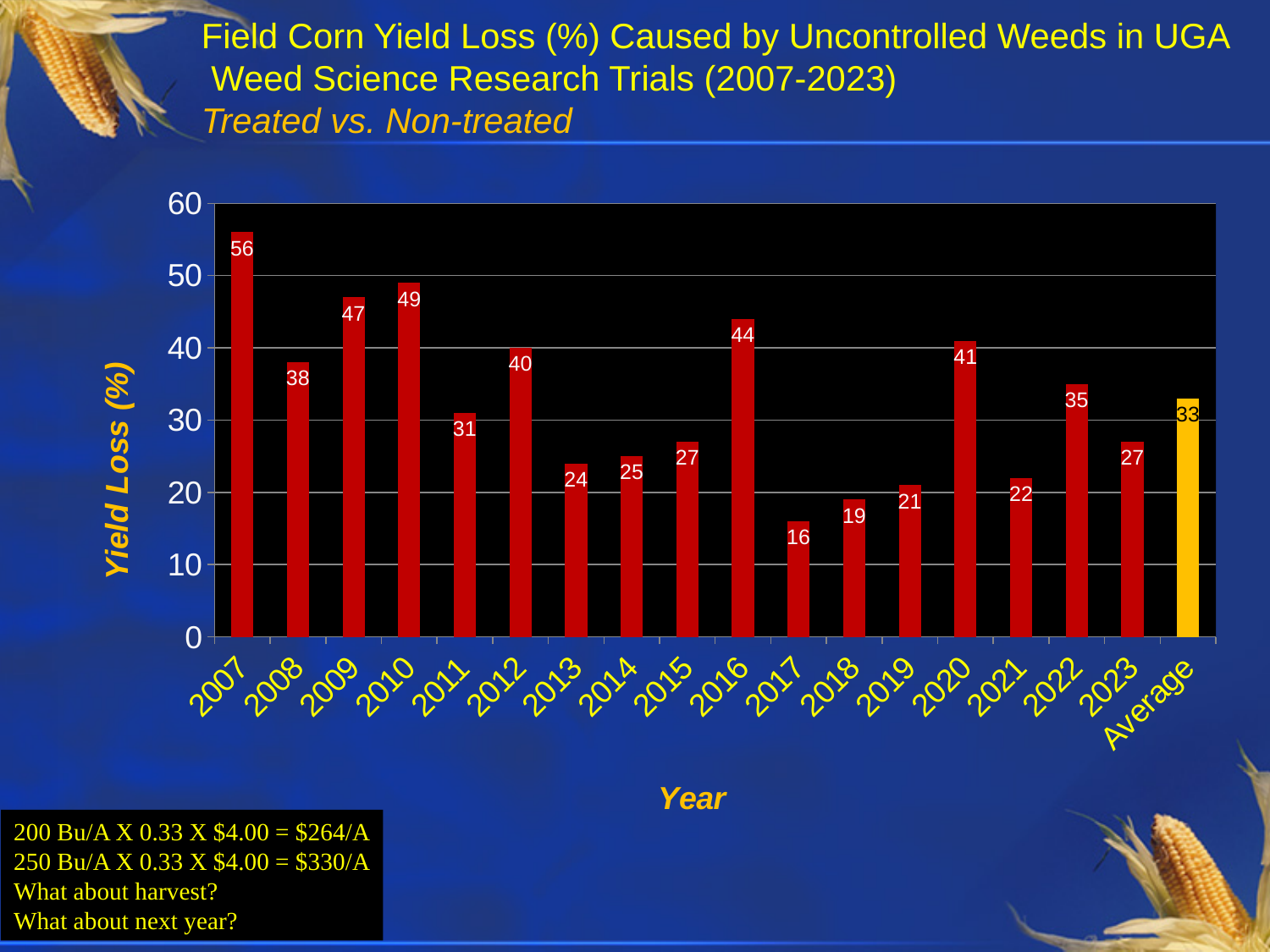
What is the yield loss value for 2007? 56 Which year has the highest yield loss? 2007 Which year has a larger yield loss, 2020 or 2022? 2020 What is the difference between the yield loss in 2016 and in 2017? 28 Is the yield loss for 2010 greater or less than 40? greater What is the value shown for the Average bar? 33 What type of chart is shown on the slide? Bar chart What is the yield loss value for 2017? 16 How many bars are plotted in the chart, including the Average bar? 18 Which year has the lowest yield loss? 2017 What is the label of the y axis? Yield Loss (%) What colour is the Average bar, compared with the red year bars? Yellow